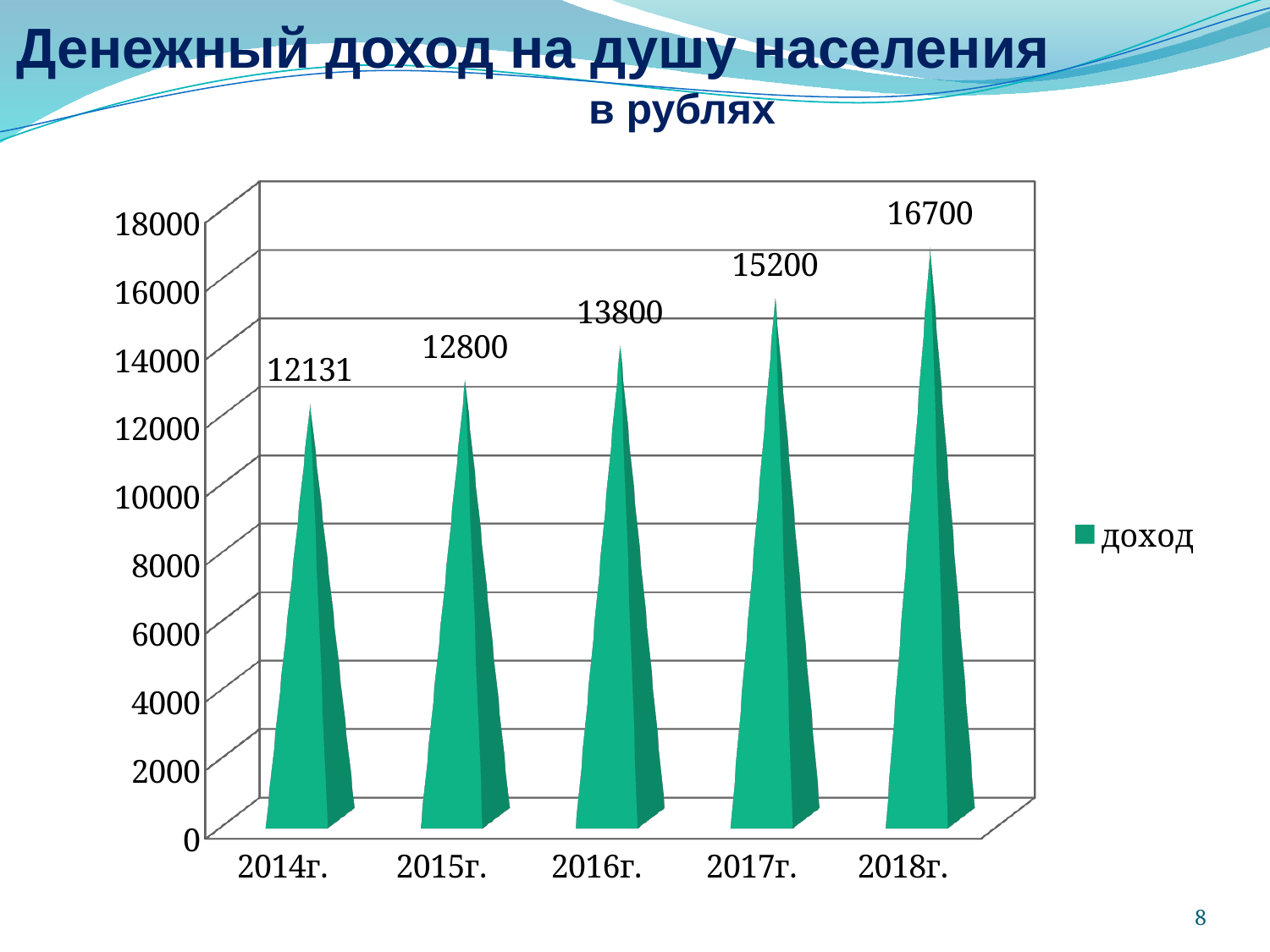
Do the values rise or fall from 2014г. to 2018г.? rise What is the value for 2018г.? 16700 What is the difference between the values for 2018г. and 2017г.? 1500 What is the value for 2014г.? 12131 Which year has the highest value? 2018г. Which year has the lowest value? 2014г. What is the value for 2016г.? 13800 What kind of chart is shown on the slide? bar chart How many years are shown on the x axis? 5 What is the difference between the values for 2015г. and 2014г.? 669 Is the value for 2017г. greater or less than 14000? greater Which is larger, the value for 2016г. or the value for 2015г.? 2016г.